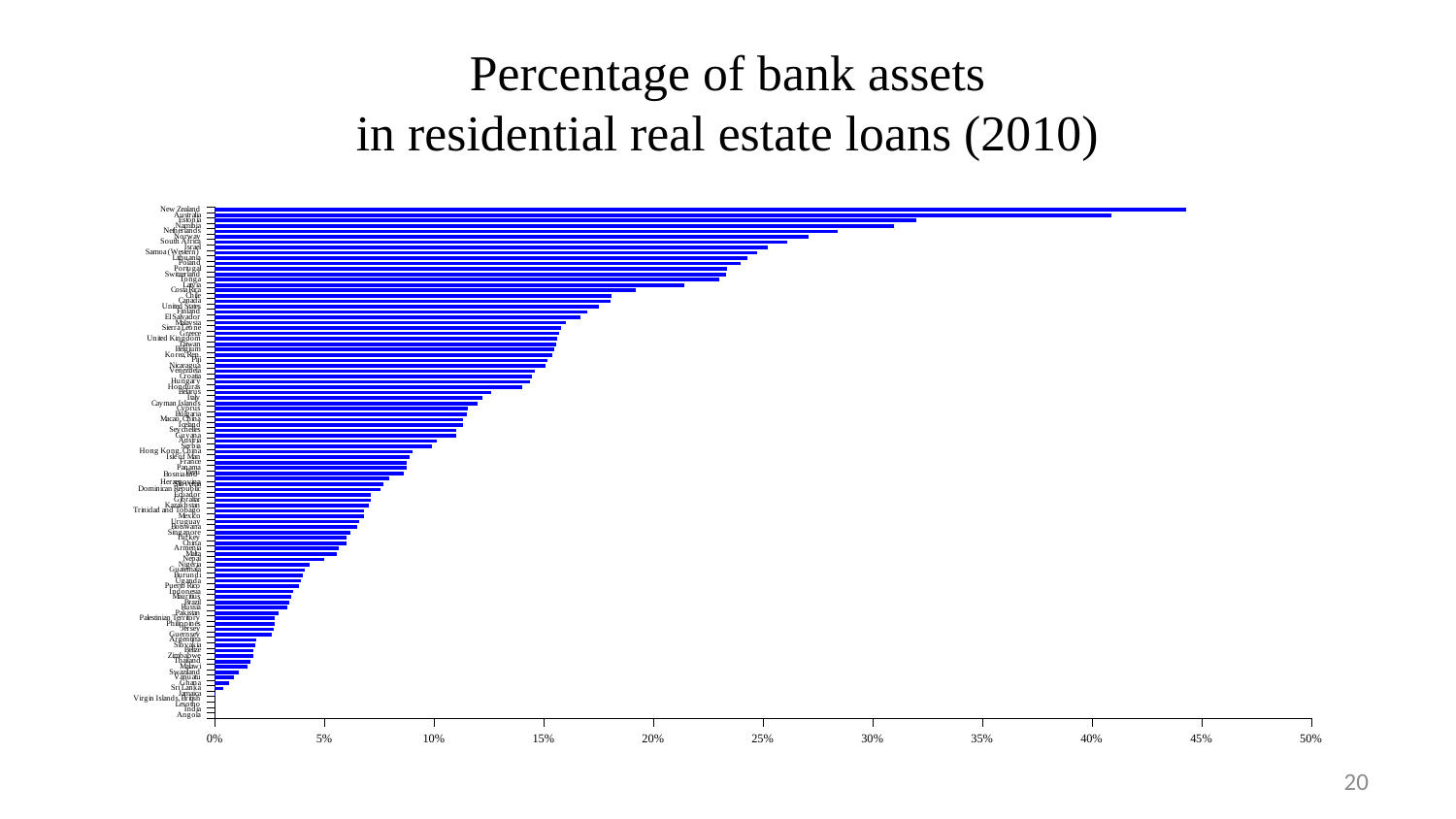
Which country appears at the bottom of the chart with the lowest value? Angola What type of chart is shown on the slide? Bar chart Is the value for Estonia greater or less than 35%? less Is the value for New Zealand greater or less than 40%? greater Is the value for South Africa greater or less than 25%? greater Which country has the highest percentage of bank assets in residential real estate loans? New Zealand What is the maximum value shown on the horizontal axis? 50% What is the title of the chart? Percentage of bank assets in residential real estate loans (2010) Which has a larger value, New Zealand or Australia? New Zealand Do the bar values increase or decrease going from the top of the chart to the bottom? decrease